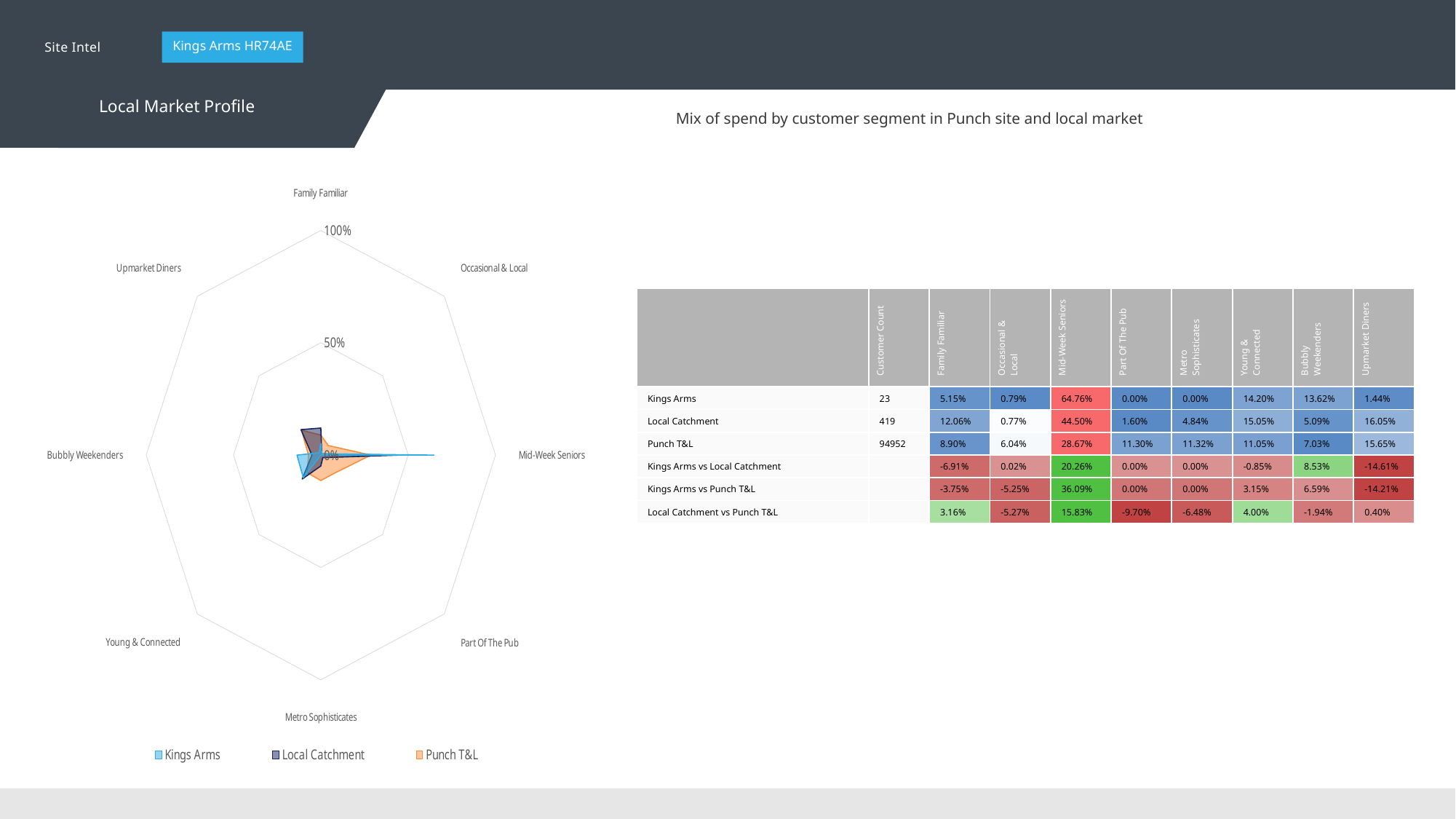
What is the maximum value shown on the radar chart's axis? 100% Which is larger for Mid-Week Seniors: the Kings Arms value or the Local Catchment value? Kings Arms What is the Punch T&L value for Mid-Week Seniors? 28.67% What is the difference between the Kings Arms and Local Catchment values for Mid-Week Seniors? 20.26% For which customer segment does the Kings Arms series reach its highest value on the radar chart? Mid-Week Seniors How many customer segment categories are plotted on the radar chart? 8 Which series are listed in the radar chart's legend? Kings Arms, Local Catchment, Punch T&L What is the Kings Arms value for Mid-Week Seniors? 64.76% Is the Kings Arms value for Mid-Week Seniors greater or less than 50%? greater What type of chart is shown on the left of the slide? Radar chart For which customer segment does the Punch T&L series reach its highest value on the radar chart? Mid-Week Seniors How many series does the legend of the radar chart list? 3